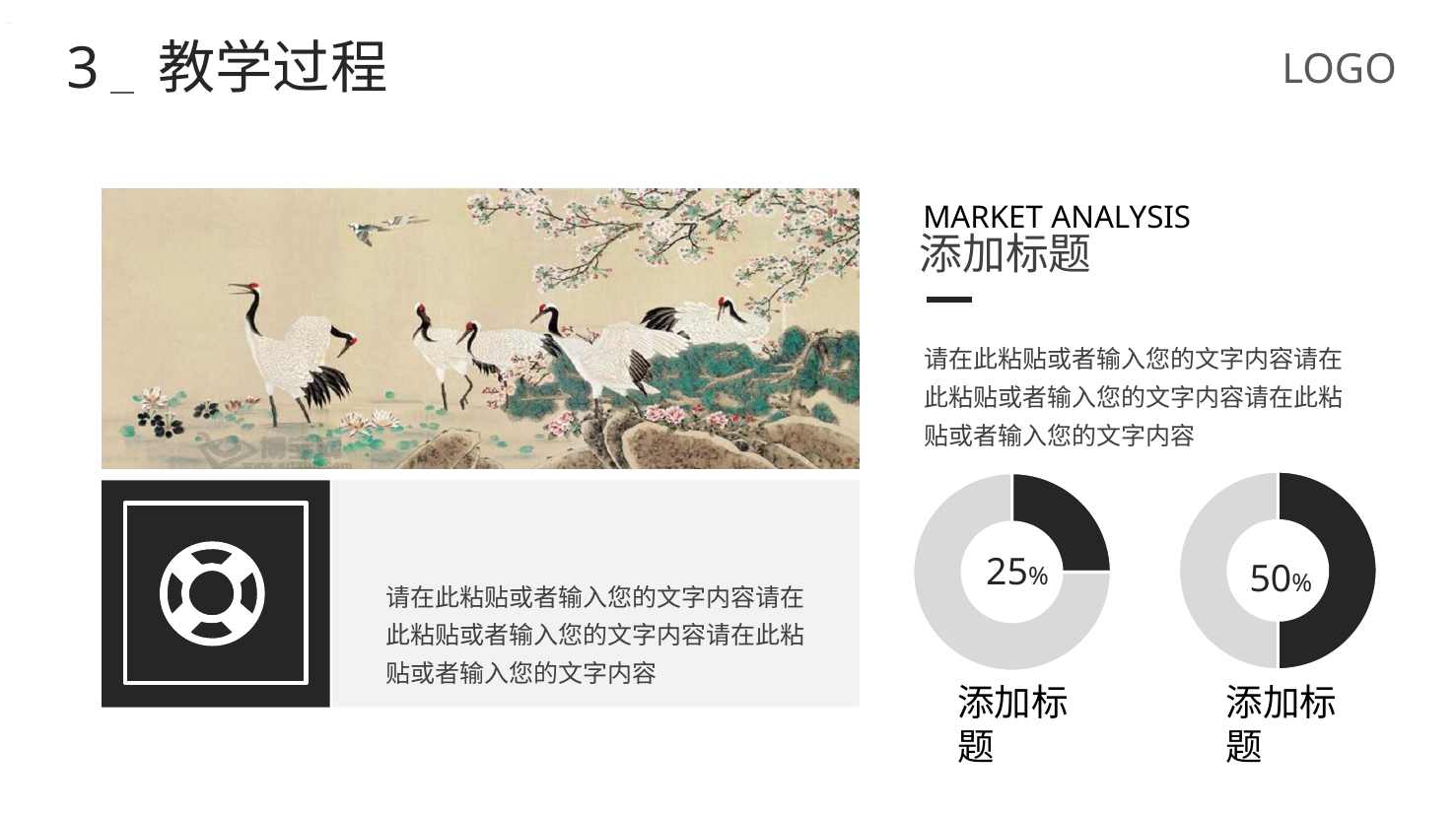
Is the value shown in the left donut chart greater or less than 50%? less In the right donut chart, what share of the ring is filled in black? 50% What percentage is shown in the centre of the left donut chart? 25% What kind of chart is used to display the 25% and 50% values on the slide? donut (pie) chart Which donut chart shows the larger percentage, the left one or the right one? the right one What two colours are used for the segments of the donut charts? black and grey What percentage is shown in the centre of the right donut chart? 50% In the left donut chart, what share of the ring is filled in black? 25% What label appears beneath each of the two donut charts? 添加标题 What is the difference between the percentage in the right donut chart and the percentage in the left donut chart? 25% How many donut charts are shown on the slide? 2